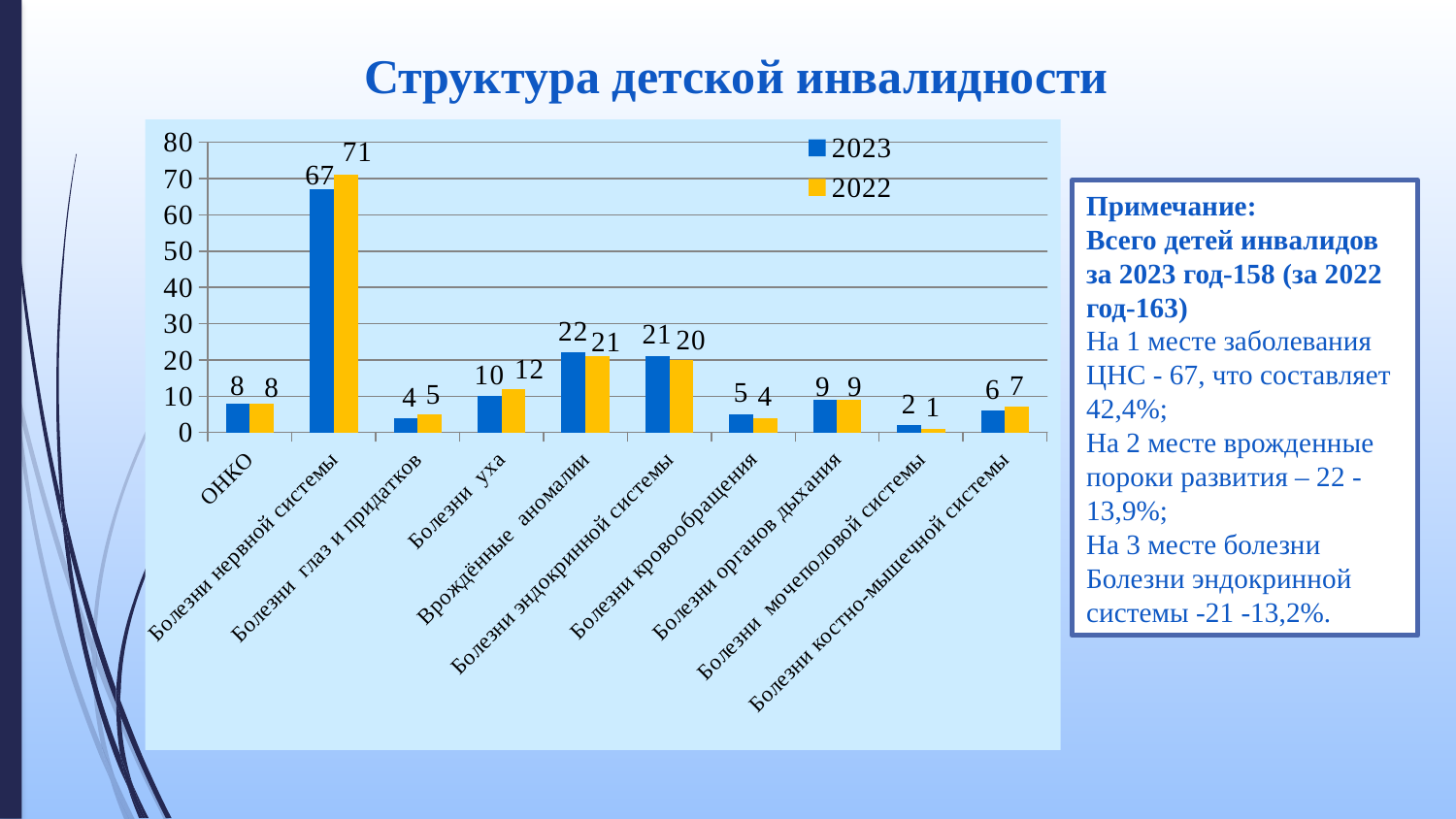
How many categories are shown on the x axis? 10 Which category has the lowest 2023 value? Болезни мочеполовой системы What is the 2023 value for Болезни нервной системы? 67 What is the title of the chart? Структура детской инвалидности What kind of chart is shown on the slide? Bar chart What is the 2023 value for Врождённые аномалии? 22 Which category has the highest 2022 value? Болезни нервной системы Which is larger for Болезни эндокринной системы: the 2023 value or the 2022 value? 2023 How many series does the legend list? 2 Which colour represents the 2022 series? Yellow What is the difference between the 2022 and 2023 values for Болезни нервной системы? 4 What is the 2022 value for Болезни уха? 12